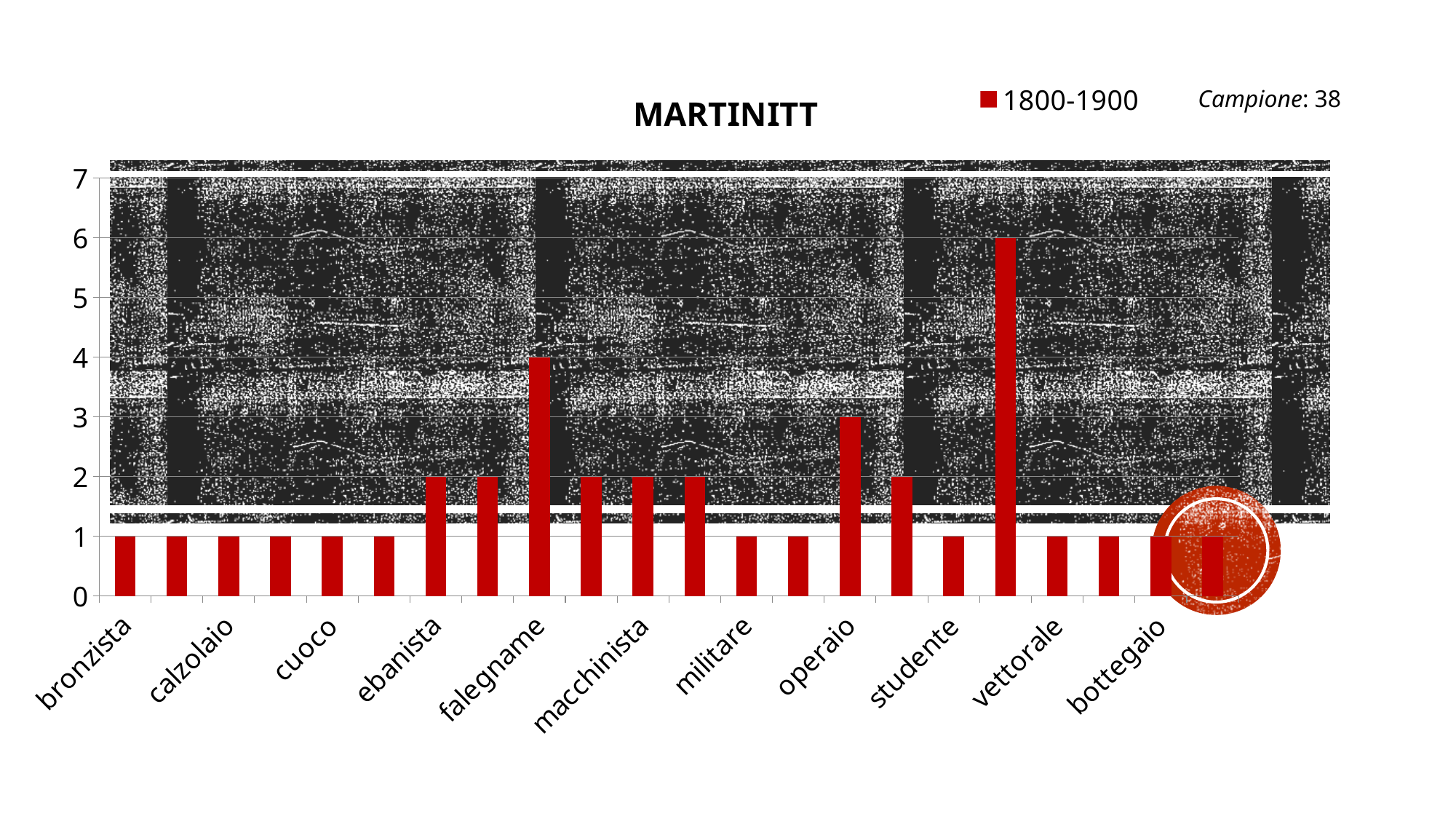
What is the value of the tallest bar in the chart? 6 What kind of chart is shown on the slide? bar chart What is the difference between the values for falegname and operaio? 1 What is the value for bronzista? 1 What is the value for ebanista? 2 Which is larger, the value for falegname or the value for operaio? falegname What sample size (Campione) is stated next to the chart? 38 What is the title of the chart? MARTINITT How many series does the legend list? 1 What is the value for falegname? 4 Which is larger, the value for macchinista or the value for militare? macchinista What is the value for operaio? 3